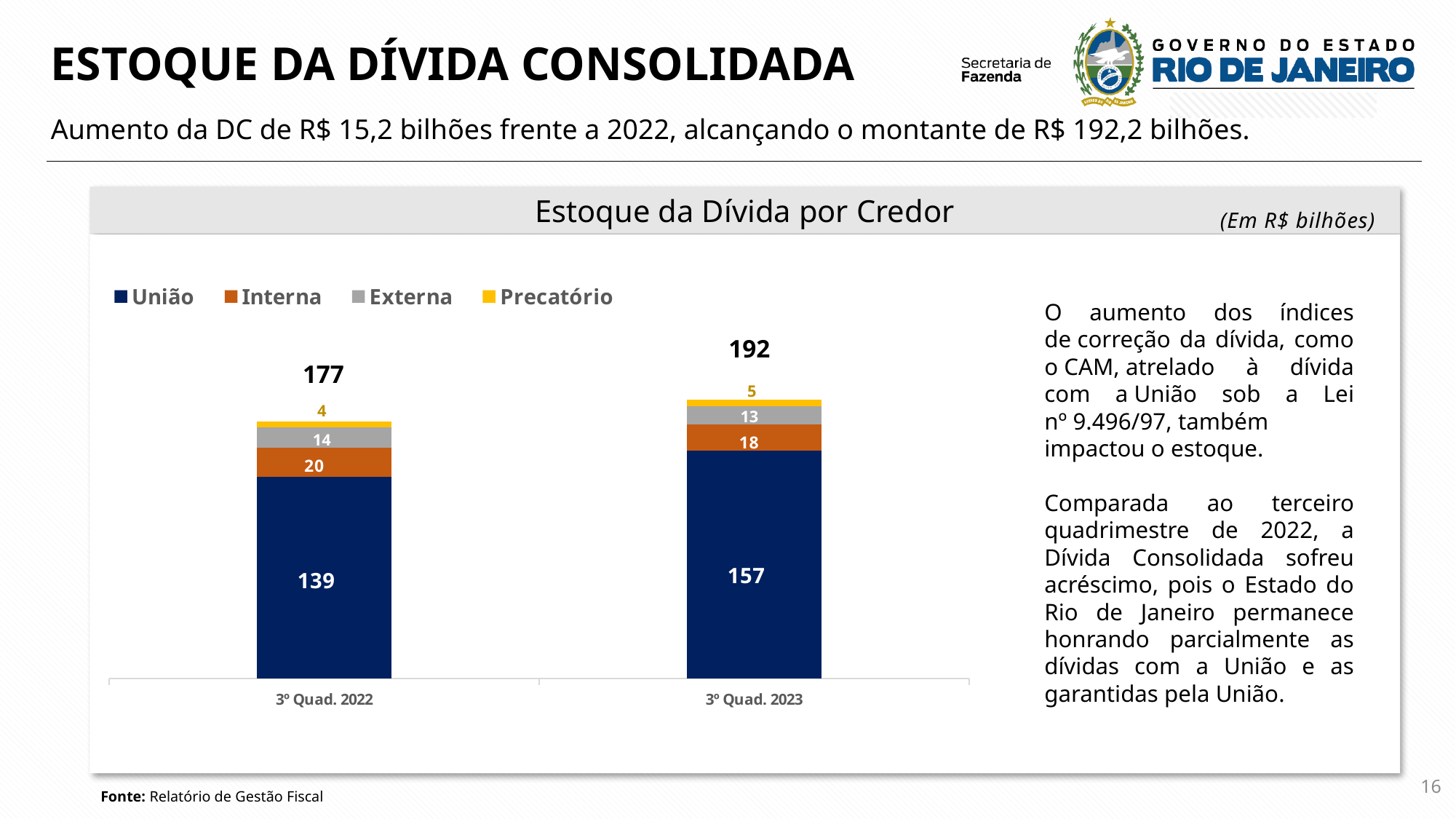
How many series does the legend list? 4 What is the total of the stacked bar for 3º Quad. 2022? 177 Which series is the largest segment in the 3º Quad. 2023 bar? União What is the value of the Interna segment for 3º Quad. 2022? 20 Which period has the larger Interna value, 3º Quad. 2022 or 3º Quad. 2023? 3º Quad. 2022 What is the total of the stacked bar for 3º Quad. 2023? 192 What is the difference between the União values for 3º Quad. 2023 and 3º Quad. 2022? 18 What is the value of the Precatório segment for 3º Quad. 2022? 4 How many categories are shown on the x axis? 2 What kind of chart is shown on the slide? Stacked bar chart What is the value of the União segment for 3º Quad. 2023? 157 What is the value of the Externa segment for 3º Quad. 2023? 13